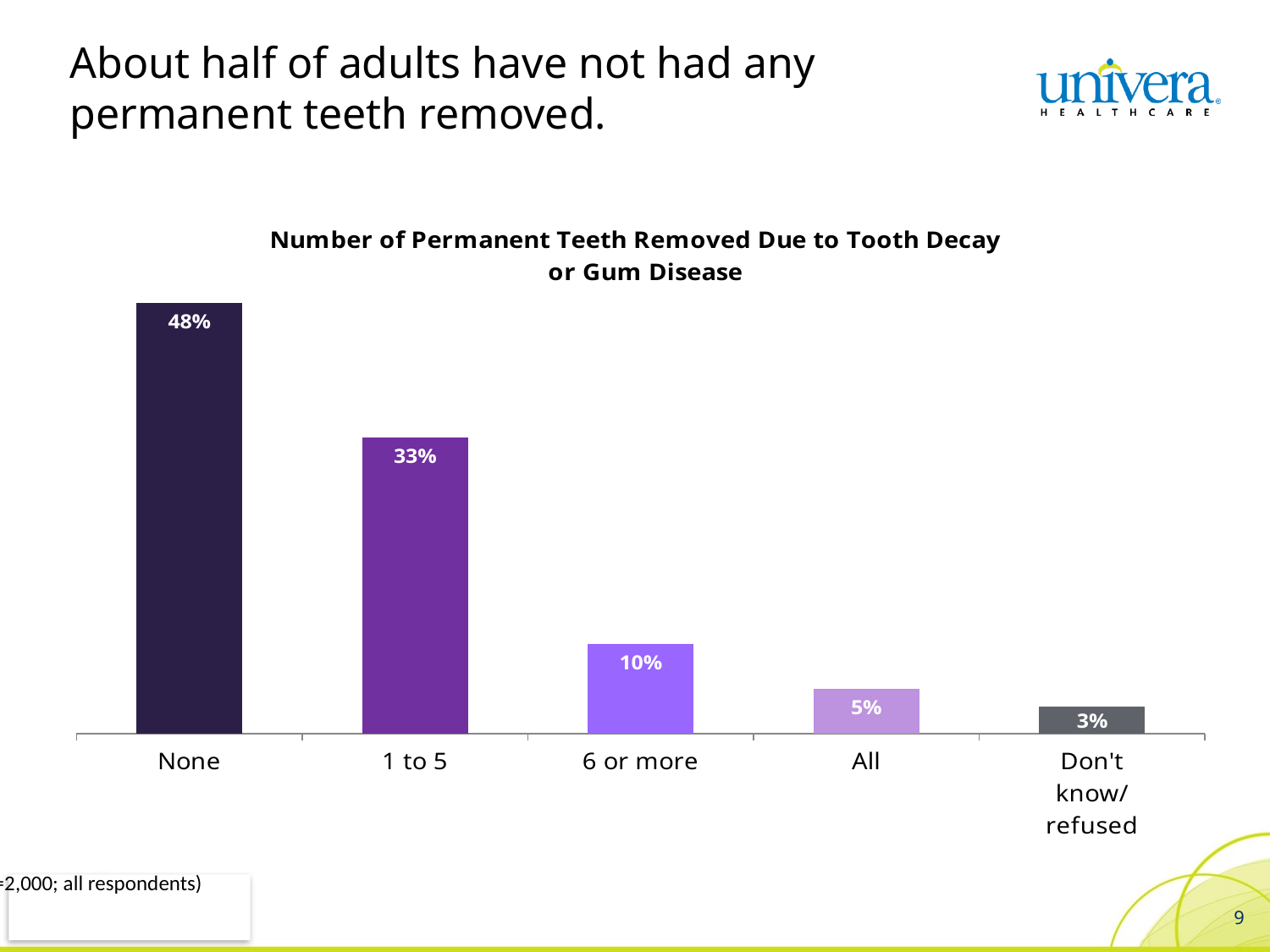
What is the title of the chart? Number of Permanent Teeth Removed Due to Tooth Decay or Gum Disease What is the difference between the '6 or more' and 'All' values? 5% What percentage of adults reported having no permanent teeth removed? 48% Which category has the lowest value? Don't know/ refused What is the value for the '1 to 5' category? 33% What percentage of respondents had 6 or more permanent teeth removed? 10% What is the value shown for 'Don't know/ refused'? 3% How many categories are shown on the x axis? 5 What is the difference between the 'None' and '1 to 5' values? 15% What kind of chart is shown on the slide? Bar chart Which is larger, the value for 'All' or the value for 'Don't know/ refused'? All Which category has the highest value? None